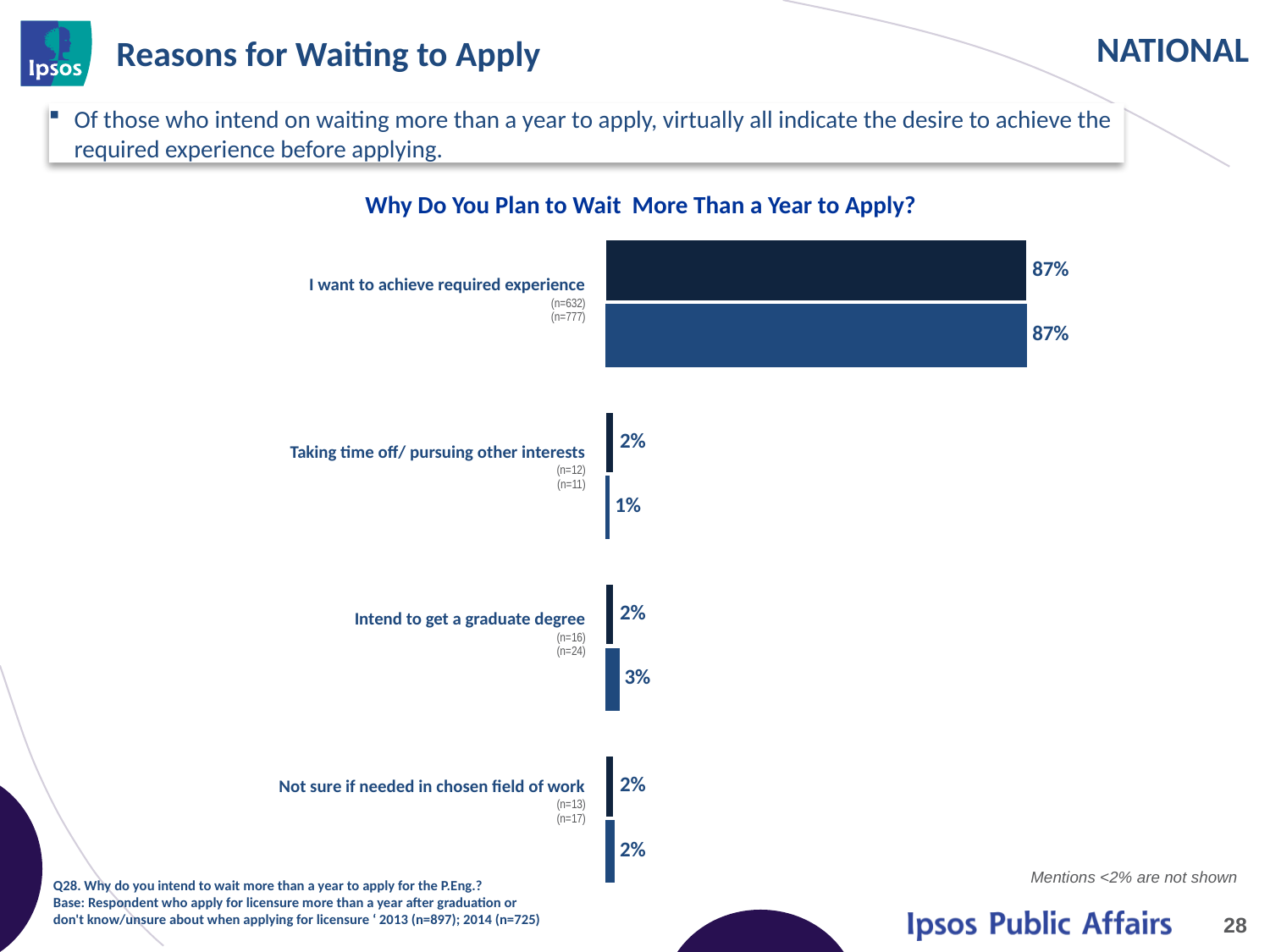
For "Taking time off/ pursuing other interests", which bar is larger, the dark navy bar or the lighter blue bar? the dark navy bar How many reasons (categories) are shown in the chart? 4 What is the difference between the lighter blue bar and the dark navy bar for "Intend to get a graduate degree"? 1% Which reason has the highest value in the chart? I want to achieve required experience What type of chart is shown on the slide? bar chart What is the value of the lighter blue (bottom) bar for "Intend to get a graduate degree"? 3% For "Intend to get a graduate degree", which bar is larger, the dark navy bar or the lighter blue bar? the lighter blue bar What is the value of the dark navy (top) bar for "I want to achieve required experience"? 87% What is the value of the dark navy (top) bar for "Not sure if needed in chosen field of work"? 2% What is the title of the chart? Why Do You Plan to Wait More Than a Year to Apply? What is the difference between the dark navy bars for "I want to achieve required experience" and "Taking time off/ pursuing other interests"? 85% What is the value of the lighter blue (bottom) bar for "Taking time off/ pursuing other interests"? 1%